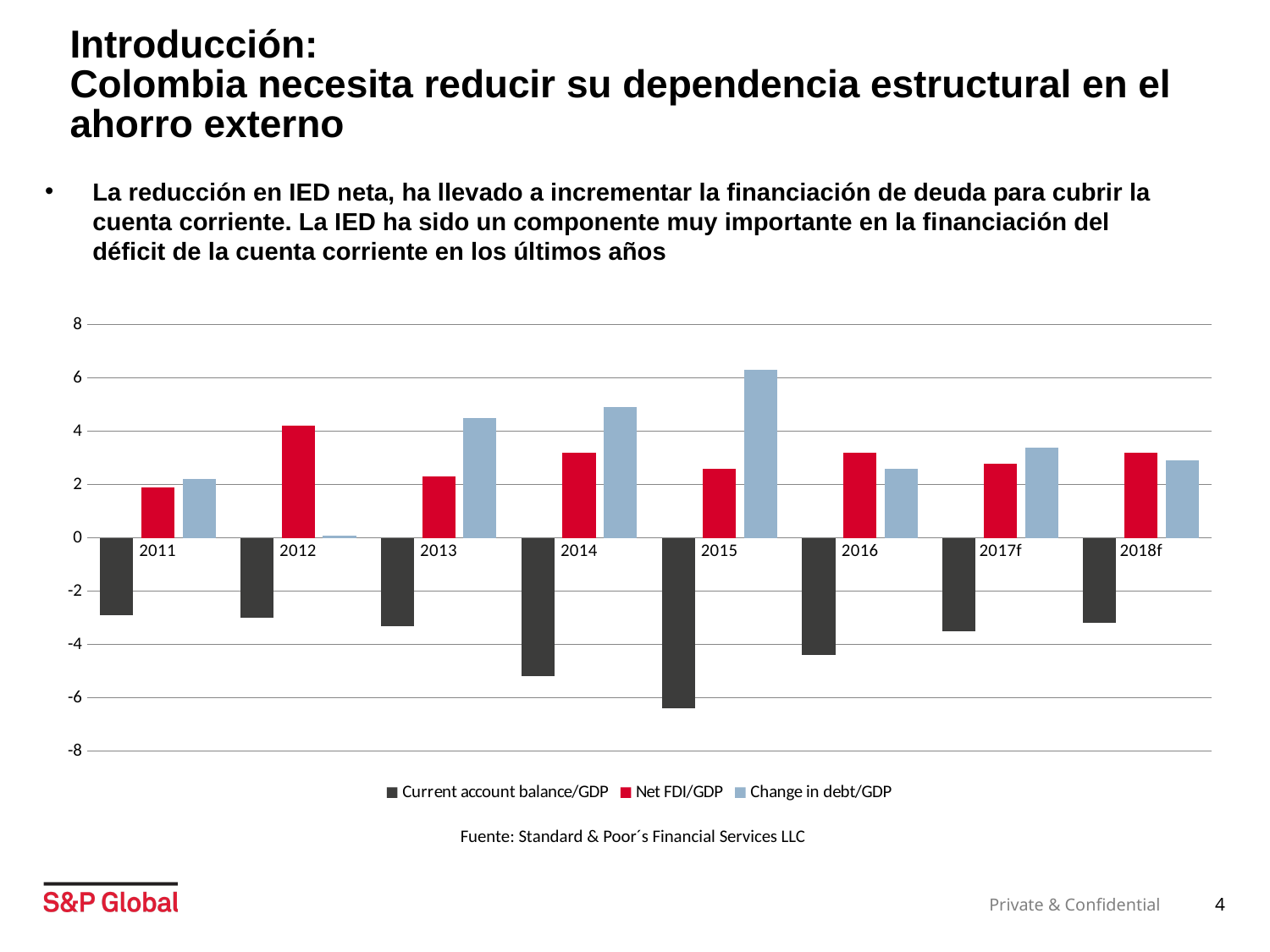
Is the value for Change in debt/GDP in 2014 greater or less than 4? greater What colour represents Net FDI/GDP in the legend? Red In which year is Current account balance/GDP lowest (most negative)? 2015 How many series does the legend list? 3 In 2013, which is larger: Net FDI/GDP or Change in debt/GDP? Change in debt/GDP How many years are shown along the x axis? 8 Is the value for Current account balance/GDP in 2014 greater or less than -4? less In which year is Change in debt/GDP highest? 2015 In 2012, which is larger: Net FDI/GDP or Change in debt/GDP? Net FDI/GDP In which year is Net FDI/GDP highest? 2012 What kind of chart is shown on the slide? Bar chart In which year is Change in debt/GDP lowest? 2012